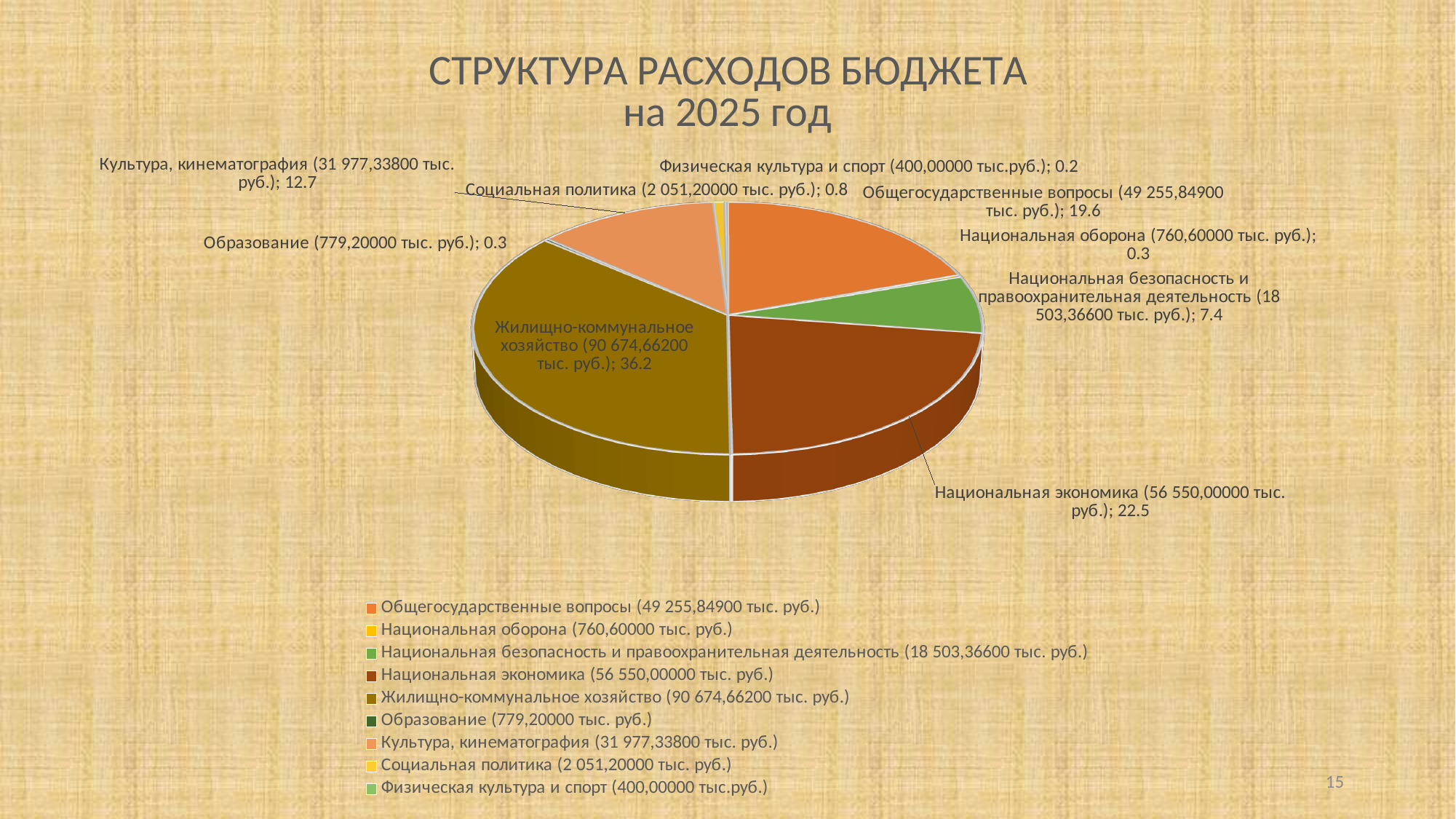
What is the value shown for Социальная политика? 2 051,20000 тыс. руб. Which category has the smallest share of the budget expenditures? Физическая культура и спорт Which category has the largest share of the budget expenditures? Жилищно-коммунальное хозяйство How many categories does the legend of the pie chart list? 9 What kind of chart is shown on the slide? Pie chart What is the title of the chart? СТРУКТУРА РАСХОДОВ БЮДЖЕТА на 2025 год What is the value shown for Национальная экономика? 56 550,00000 тыс. руб. What share of the pie does Культура, кинематография take? 12.7 What is the difference in share between Жилищно-коммунальное хозяйство (36.2) and Национальная экономика (22.5)? 13.7 Which has the larger share: Общегосударственные вопросы or Национальная безопасность и правоохранительная деятельность? Общегосударственные вопросы What is the value shown for Общегосударственные вопросы? 49 255,84900 тыс. руб. What share of the pie does Жилищно-коммунальное хозяйство take? 36.2